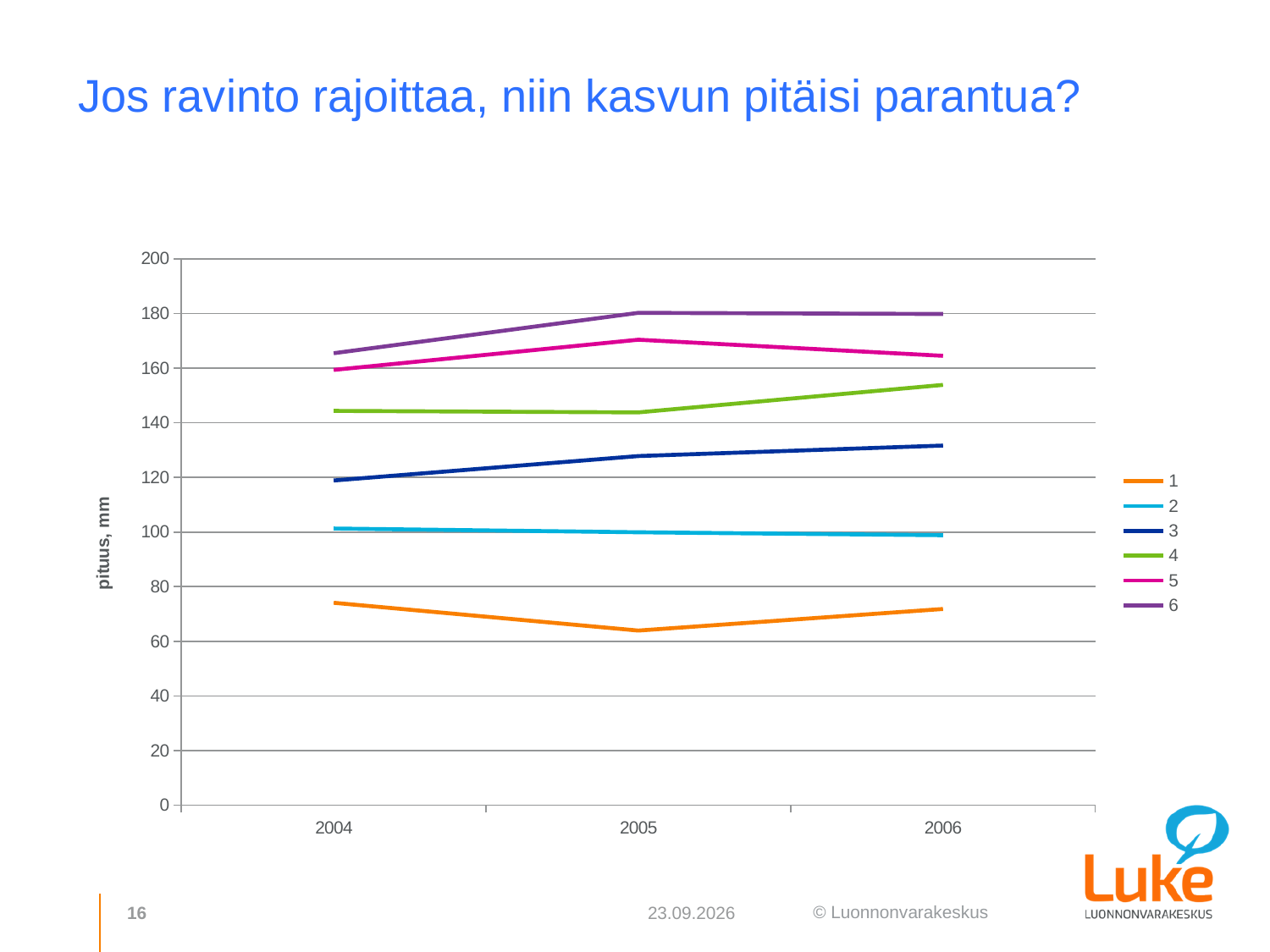
How many years are shown on the x axis? 3 Which series has the lowest value in 2005? 1 Which series has the highest value in 2006? 6 Is the value for series 4 in 2006 greater or less than 140? greater What is the label of the y axis? pituus, mm Is the value for series 3 in 2006 greater or less than 120? greater In 2005, which is larger: the value for series 4 or series 3? series 4 What kind of chart is shown on the slide? line chart Is the value for series 6 in 2005 greater or less than 160? greater Does the value for series 3 rise or fall from 2004 to 2006? rise How many series does the legend list? 6